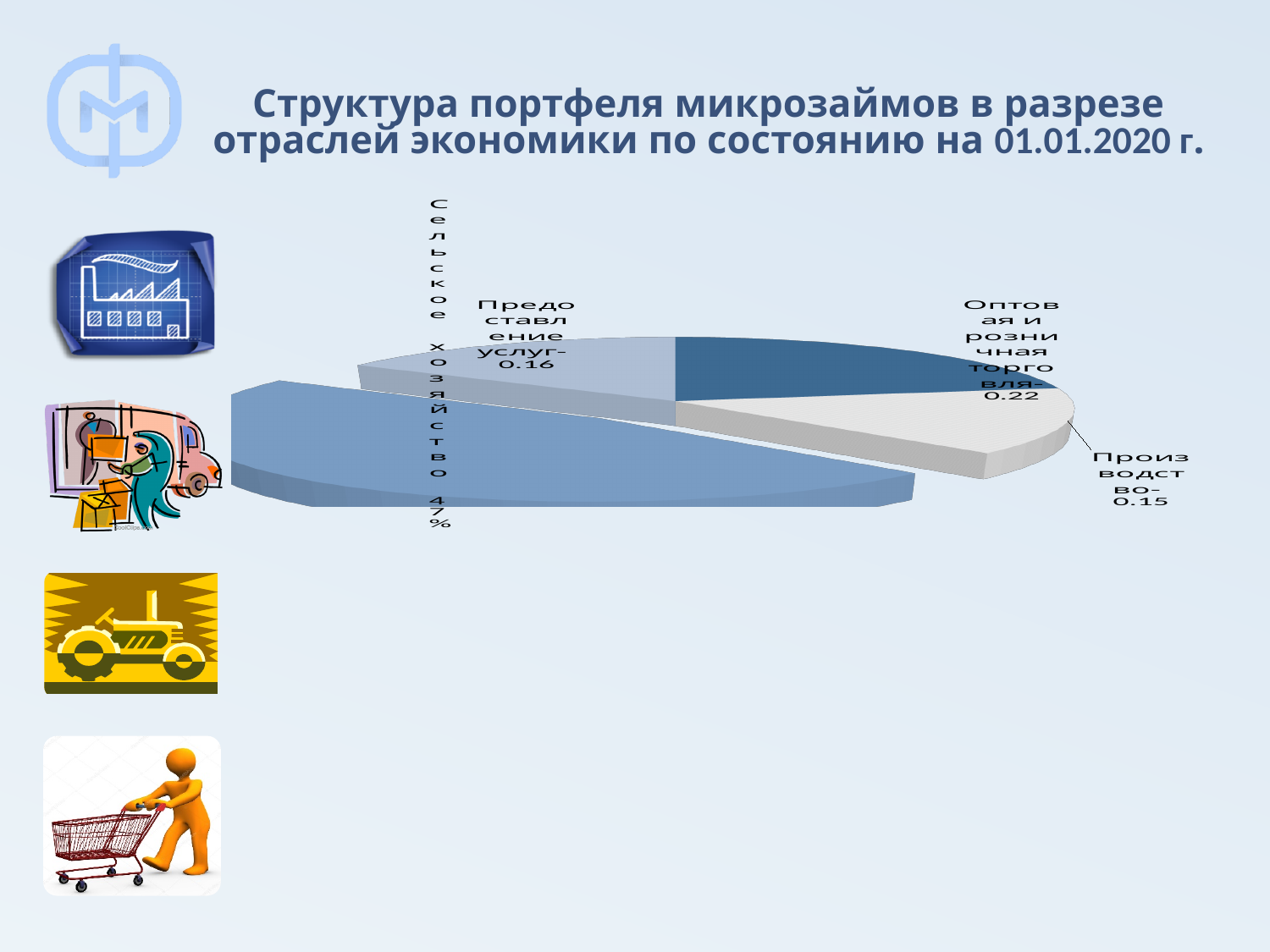
Which sector has the smallest slice of the pie? Производство Which is larger: the slice for Оптовая и розничная торговля or the slice for Предоставление услуг? Оптовая и розничная торговля How many slices does the pie chart have? 4 What is the difference between the values for Оптовая и розничная торговля and Производство? 0.07 As of what date does the slide title say the microloan portfolio structure is shown? 01.01.2020 г. What is the difference between the values for Оптовая и розничная торговля and Предоставление услуг? 0.06 What kind of chart is shown on the slide? Pie chart Which sector has the largest slice of the pie? Сельское хозяйство What value is shown for Предоставление услуг? 0.16 What value is shown for Оптовая и розничная торговля? 0.22 What value is shown for Производство? 0.15 What value is shown for Сельское хозяйство? 47%